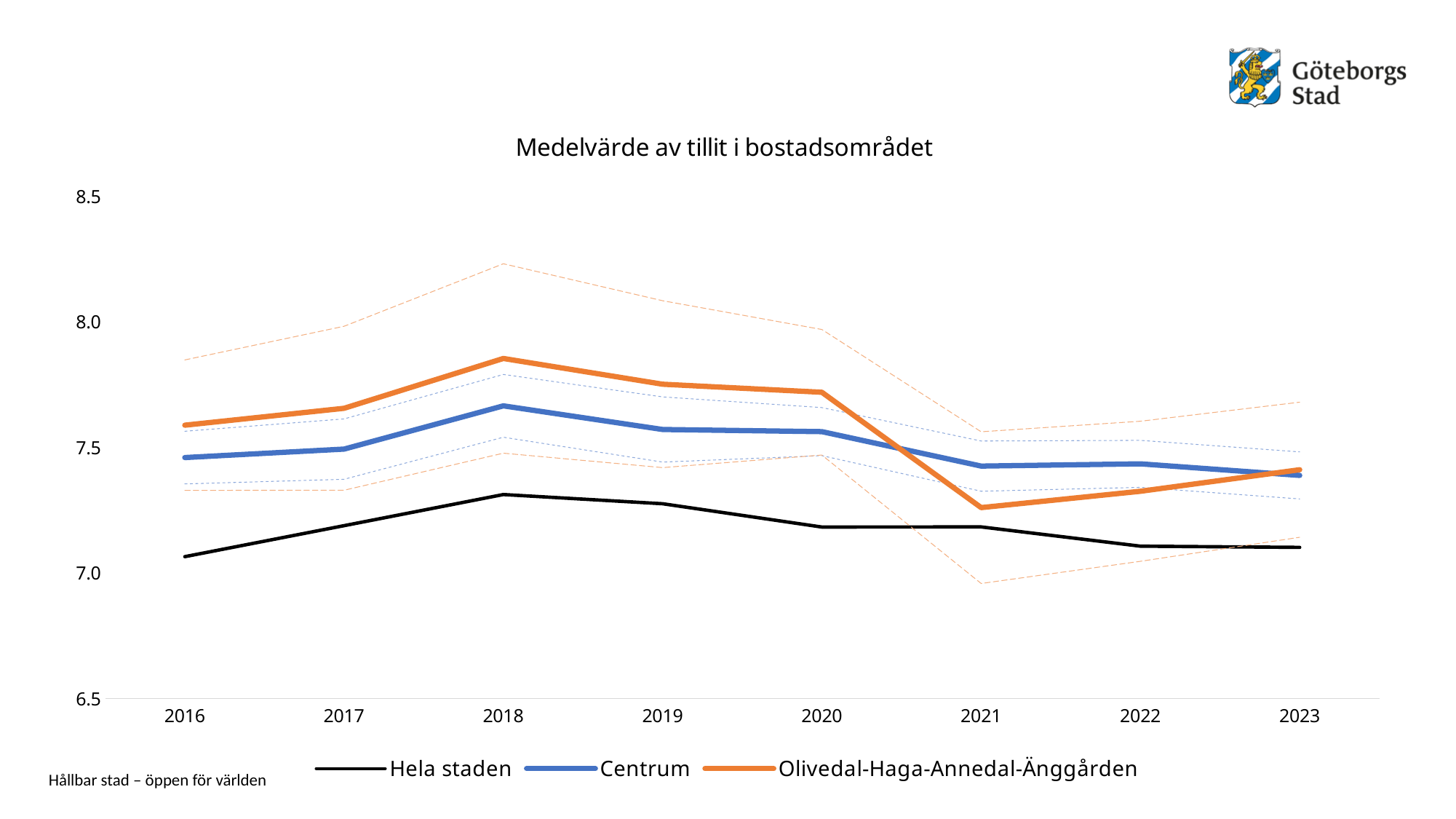
What is the title of the chart? Medelvärde av tillit i bostadsområdet What kind of chart is shown on the slide? line chart Is the value for Hela staden in 2016 greater or less than 7.5? less Does the Hela staden line rise or fall from 2018 to 2023? fall How many years are shown on the x axis? 8 In which year does the Olivedal-Haga-Annedal-Änggården line reach its lowest value? 2021 How many series does the legend list? 3 In 2016, which is larger: Centrum or Olivedal-Haga-Annedal-Änggården? Olivedal-Haga-Annedal-Änggården Is the value for Olivedal-Haga-Annedal-Änggården in 2018 greater or less than 7.5? greater In which year does the Hela staden line reach its highest value? 2018 In 2021, which is larger: Centrum or Olivedal-Haga-Annedal-Änggården? Centrum In which year does the Olivedal-Haga-Annedal-Änggården line reach its highest value? 2018